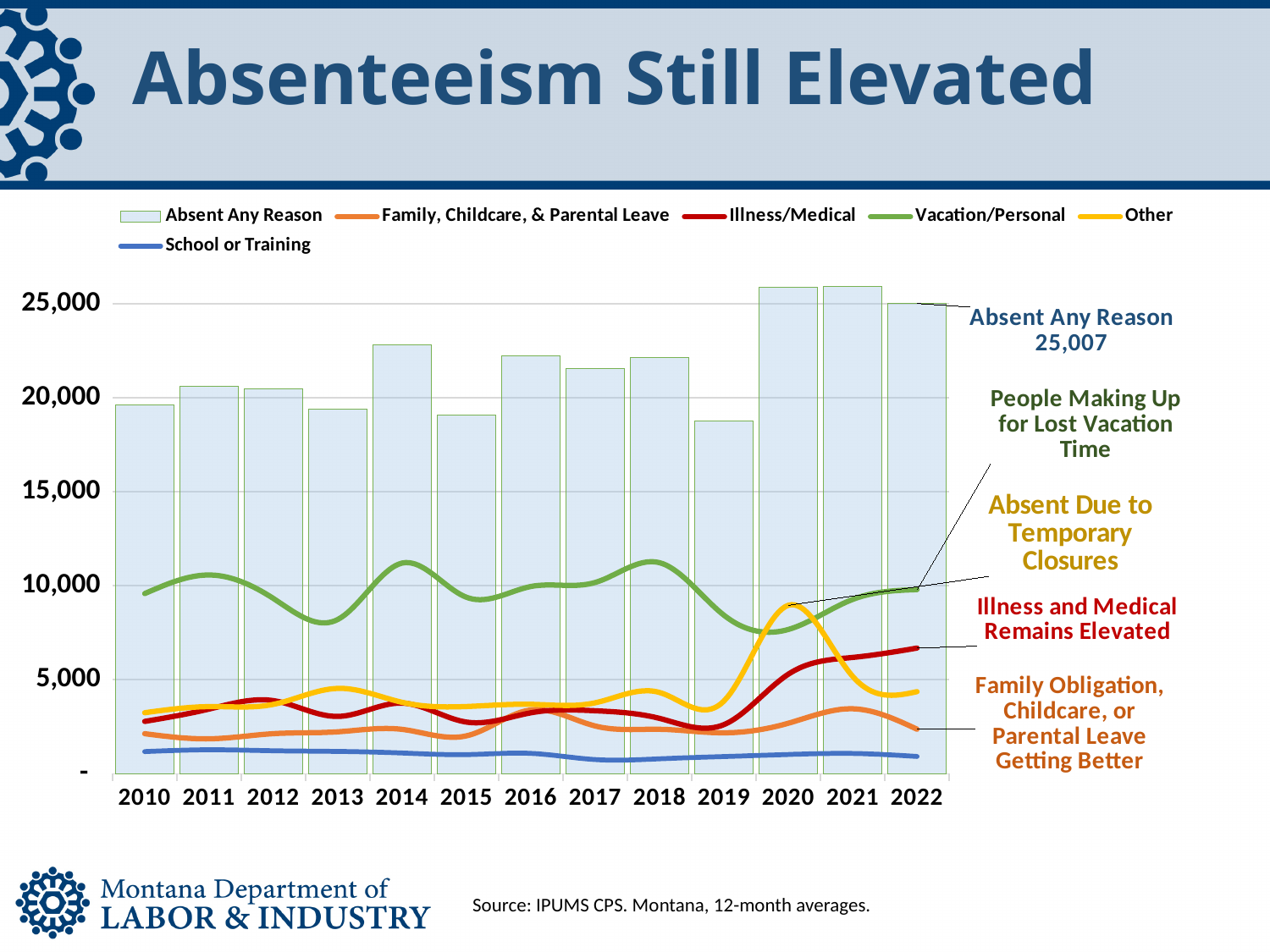
Is the value for Absent Any Reason in 2020 greater or less than 25,000? greater Which series is the lowest line across all years? School or Training Does the Illness/Medical line rise or fall from 2019 to 2022? rise Is the value for Other in 2020 greater or less than 5,000? greater What is the value of Absent Any Reason in 2022? 25,007 How many series does the legend list? 6 Which series is plotted as bars rather than a line? Absent Any Reason What kind of chart is this? Combined bar and line chart Is the value for Vacation/Personal in 2014 greater or less than 10,000? greater How many years are shown on the x axis? 13 In 2018, which is larger: Vacation/Personal or Illness/Medical? Vacation/Personal